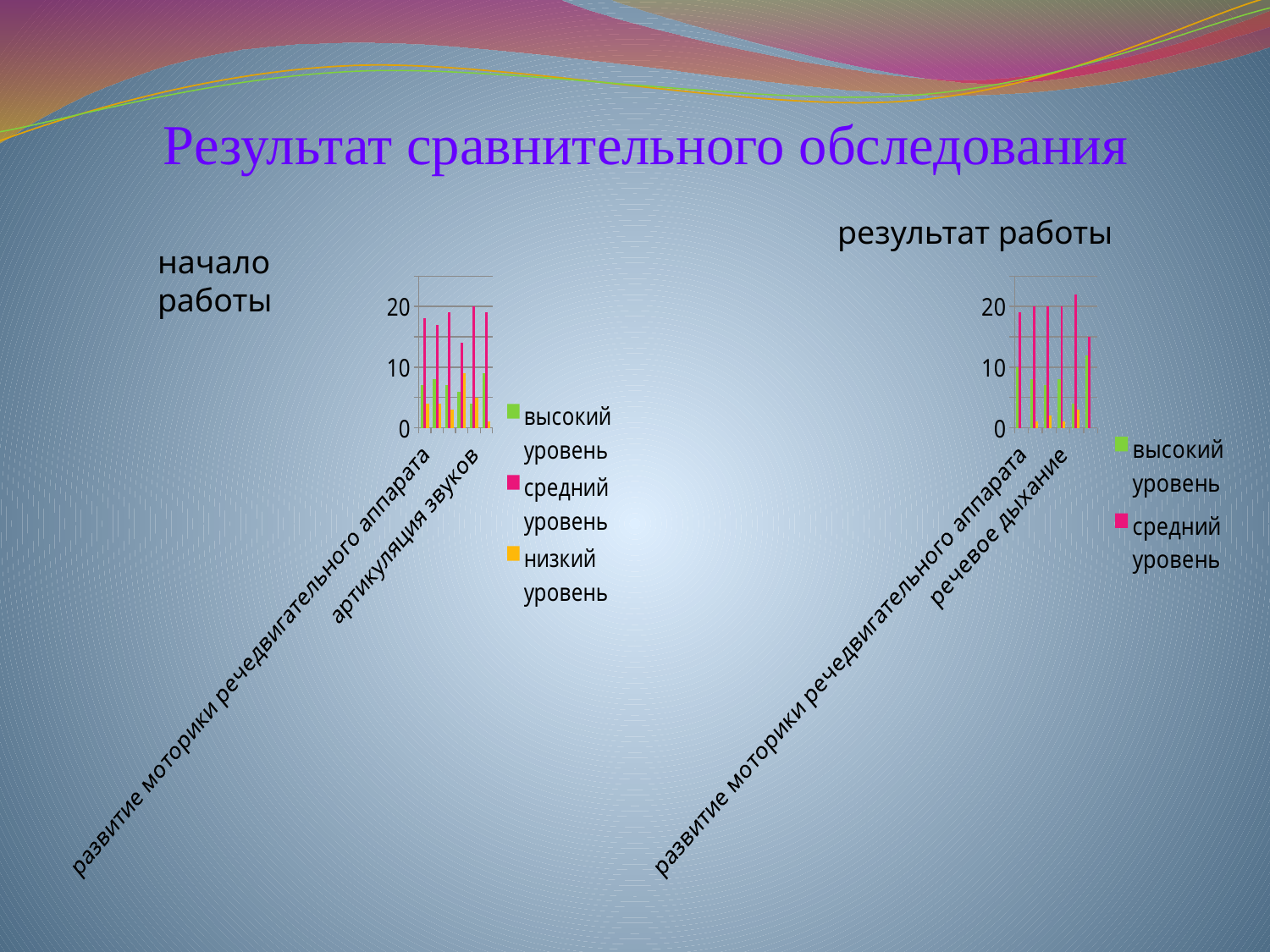
What is the title shown above the right chart? результат работы How many series does the legend of the right chart (результат работы) list? 2 What kind of chart is the left chart (начало работы)? bar chart In the right chart (результат работы), is the tallest средний уровень bar greater or less than 20? greater Which series is missing from the legend of the right chart (результат работы) compared with the left chart? низкий уровень What kind of chart is the right chart (результат работы)? bar chart In the left chart (начало работы), which series has the shortest bars overall? низкий уровень How many series does the legend of the left chart (начало работы) list? 3 In the left chart (начало работы), is the tallest средний уровень bar greater or less than 10? greater In the right chart (результат работы), which series has the taller bars, высокий уровень or средний уровень? средний уровень In the left chart (начало работы), are the низкий уровень bars greater or less than 10? less In the left chart (начало работы), which series has the tallest bars overall? средний уровень